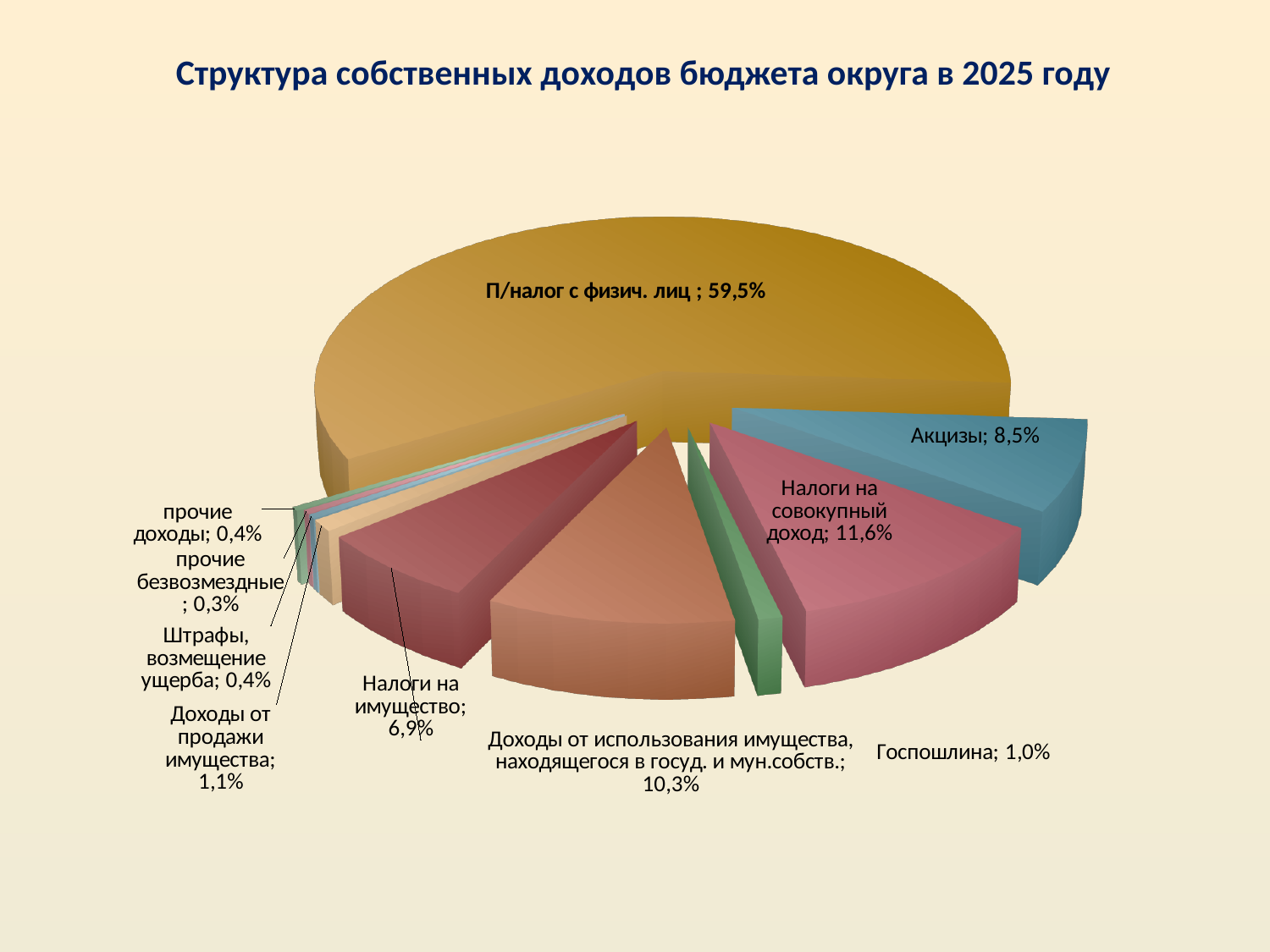
What share of the pie does П/налог с физич. лиц account for? 59,5% Which category has the largest slice of the pie? П/налог с физич. лиц What is the difference between the shares of Налоги на совокупный доход and Акцизы? 3,1% What is the value shown for Налоги на совокупный доход? 11,6% What is the value shown for Госпошлина? 1,0% What is the value shown for Акцизы? 8,5% What kind of chart is shown on the slide? pie chart Which category has the smallest slice of the pie? прочие безвозмездные Which is larger: Доходы от использования имущества, находящегося в госуд. и мун.собств. or Налоги на имущество? Доходы от использования имущества, находящегося в госуд. и мун.собств. How many slices does the pie chart have? 10 What is the title of the chart? Структура собственных доходов бюджета округа в 2025 году What is the value shown for Налоги на имущество? 6,9%